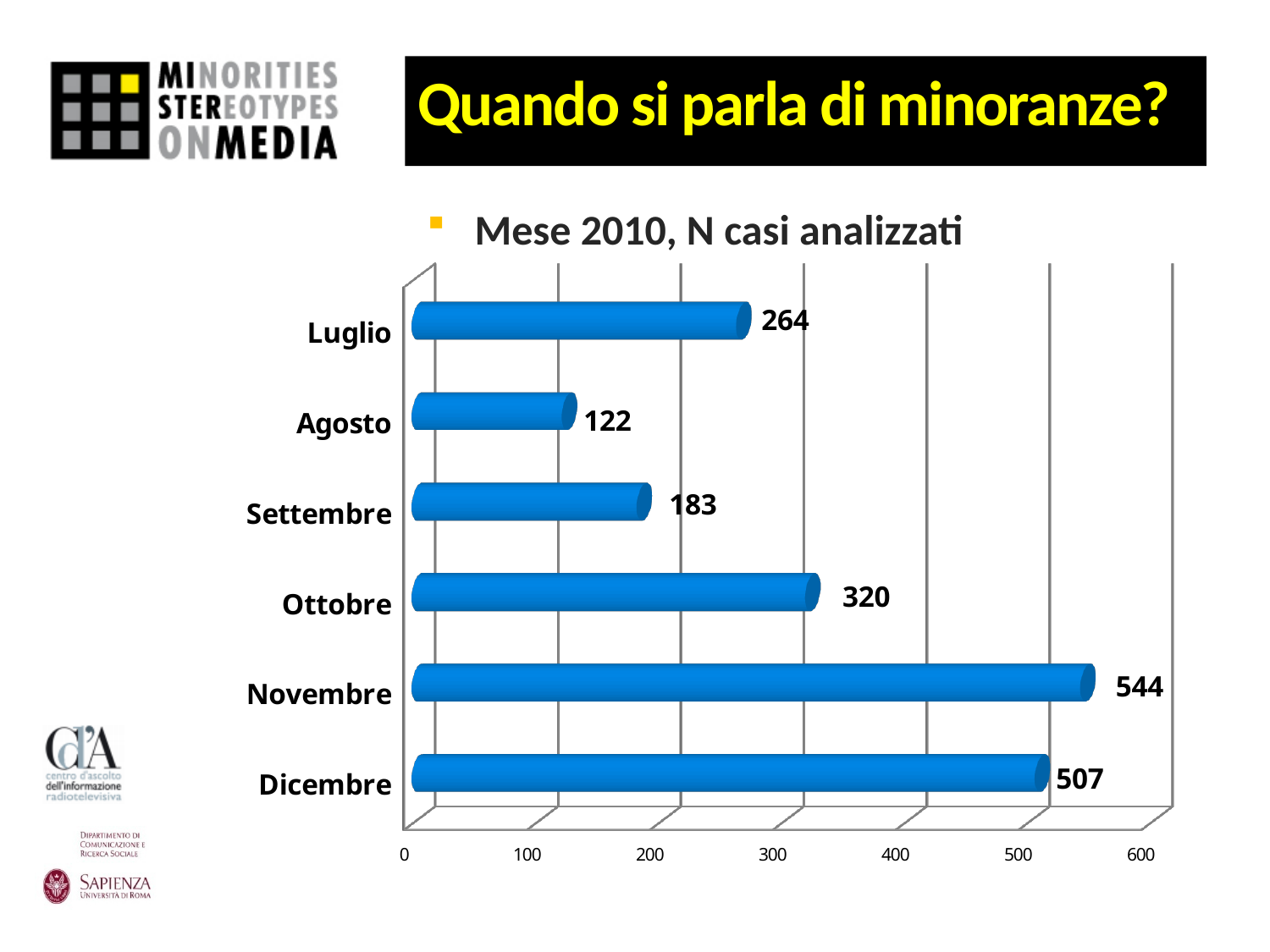
What is the value for Ottobre? 320 Which month has the highest value? Novembre What is the difference between the values for Novembre and Dicembre? 37 What is the difference between the values for Luglio and Settembre? 81 What is the title of the chart? Mese 2010, N casi analizzati Which is larger, the value for Settembre or the value for Ottobre? Ottobre What is the value for Agosto? 122 Which month has the lowest value? Agosto How many months are shown in the chart? 6 Is the value for Dicembre greater or less than 400? greater What kind of chart is shown on the slide? bar chart What is the value for Luglio? 264